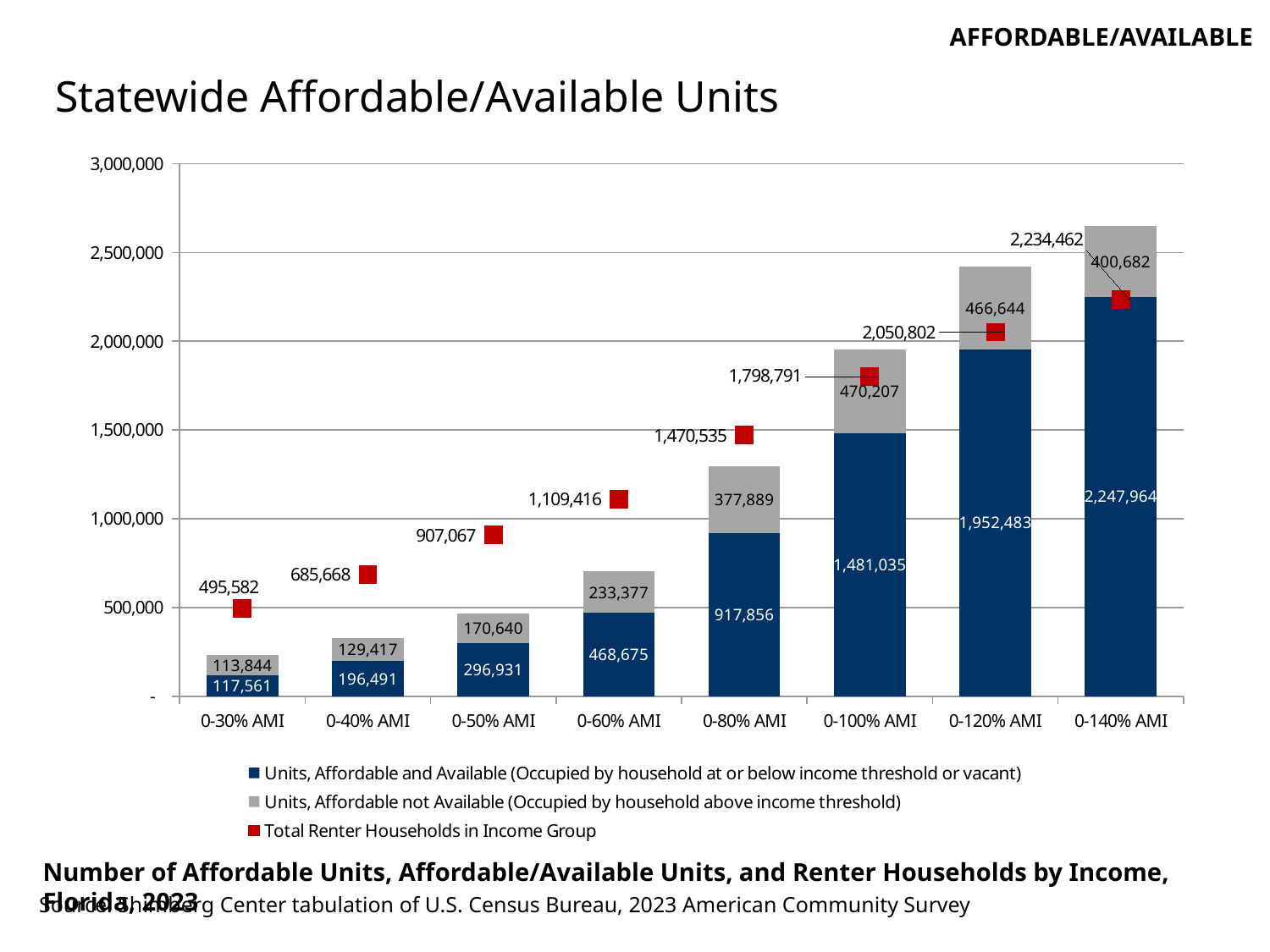
What is the value of Total Renter Households in Income Group for 0-50% AMI? 907,067 Which income group has the lowest value for Total Renter Households in Income Group? 0-30% AMI What is the value of Units, Affordable and Available for 0-60% AMI? 468,675 What is the total height of the stacked bar for 0-30% AMI? 231,405 For 0-140% AMI, which is larger: Units, Affordable and Available or Total Renter Households in Income Group? Units, Affordable and Available What is the value of Units, Affordable not Available for 0-80% AMI? 377,889 Is the value of Total Renter Households in Income Group for 0-80% AMI greater or less than 1,500,000? less Do the values for Units, Affordable and Available rise or fall from 0-30% AMI to 0-140% AMI? rise How many series does the legend list? 3 Which income group has the highest value for Units, Affordable and Available? 0-140% AMI How many income group categories are shown on the x axis? 8 What is the difference between Units, Affordable and Available for 0-120% AMI and for 0-100% AMI? 471,448